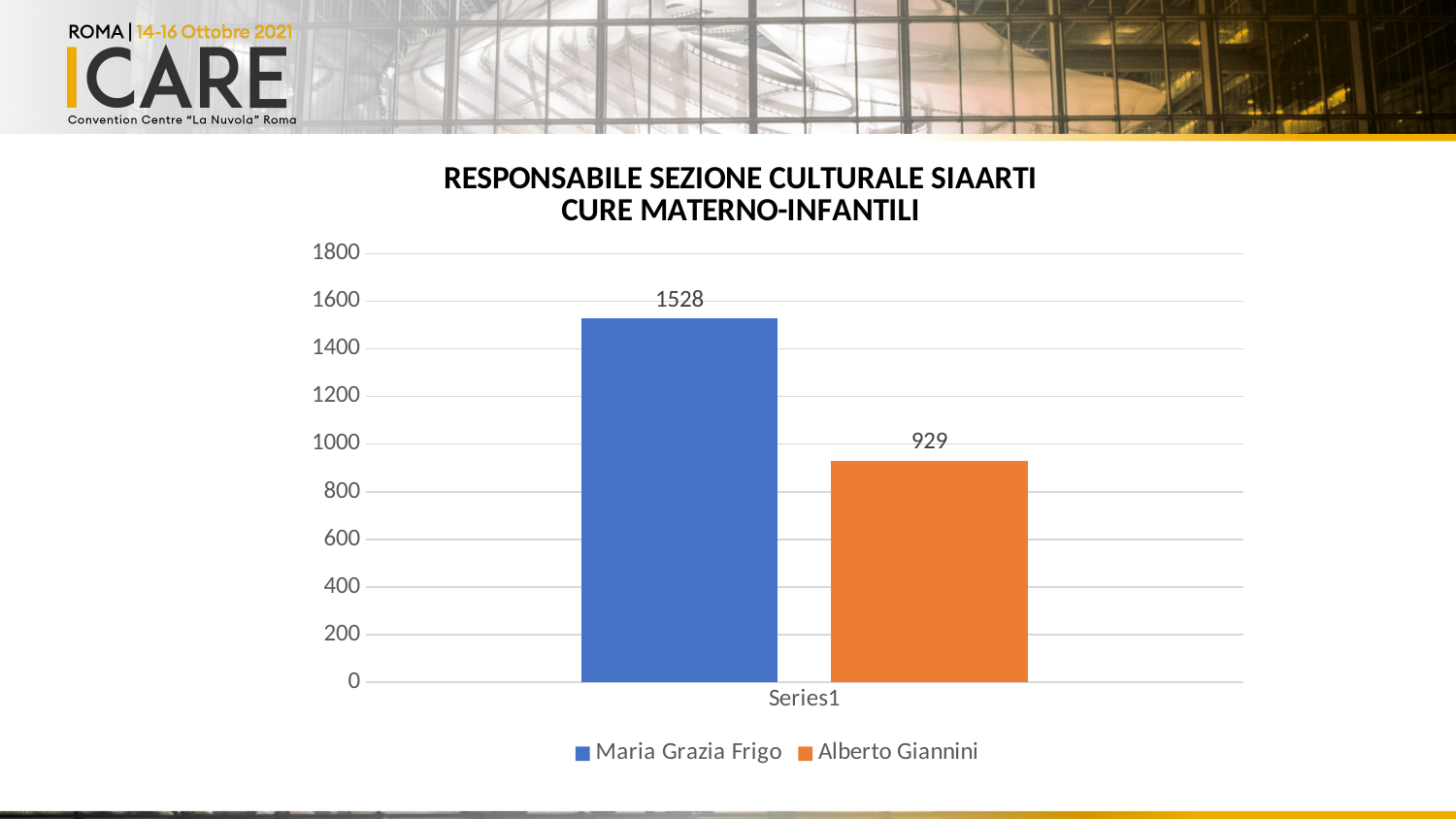
What is the value for Maria Grazia Frigo? 1528 Which series has the lowest value? Alberto Giannini What is the title of the chart? RESPONSABILE SEZIONE CULTURALE SIAARTI CURE MATERNO-INFANTILI Which series has the highest value? Maria Grazia Frigo What is the difference between the values for Maria Grazia Frigo and Alberto Giannini? 599 Is the value for Alberto Giannini greater or less than 1000? less Which is larger, the value for Maria Grazia Frigo or the value for Alberto Giannini? Maria Grazia Frigo What colour is the bar for Alberto Giannini? Orange What kind of chart is shown on the slide? Bar chart How many series does the legend list? 2 Is the value for Maria Grazia Frigo greater or less than 1400? greater What is the value for Alberto Giannini? 929